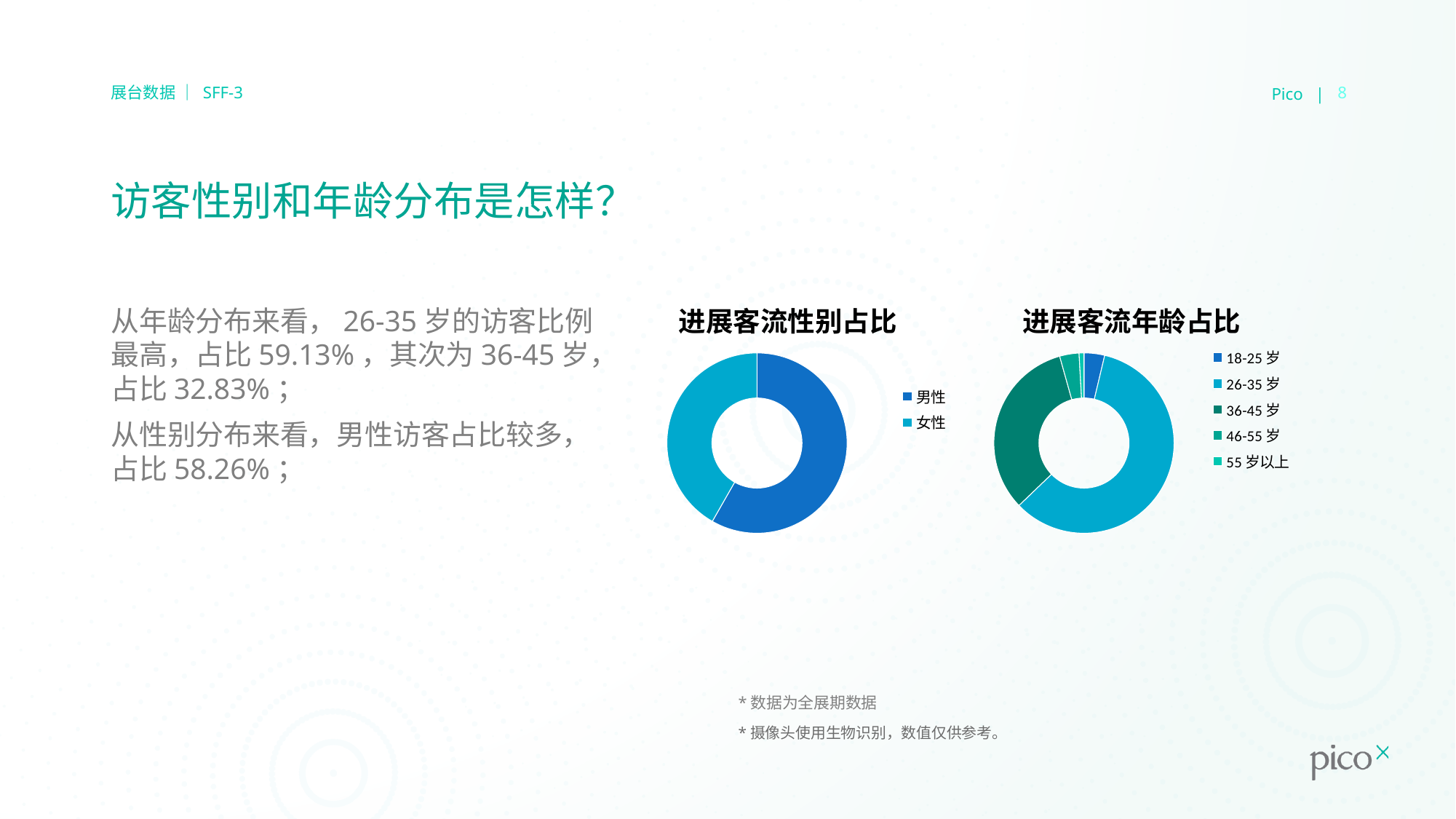
In the 进展客流年龄占比 chart, what is the share of the 26-35 岁 group? 59.13% In the 进展客流年龄占比 chart, which age group has the largest share? 26-35 岁 What kind of chart is the 进展客流性别占比 chart? Donut (pie) chart What is the title of the chart on the right side of the slide? 进展客流年龄占比 How many categories does the legend of the 进展客流性别占比 chart list? 2 In the 进展客流年龄占比 chart, what is the share of the 36-45 岁 group? 32.83% In the 进展客流年龄占比 chart, what is the difference between the shares of the 26-35 岁 and 36-45 岁 groups? 26.30% In the 进展客流年龄占比 chart, which age group is the second largest? 36-45 岁 How many categories does the legend of the 进展客流年龄占比 chart list? 5 In the 进展客流性别占比 chart, what is the share of 男性? 58.26% In the 进展客流年龄占比 chart, which is larger: the 36-45 岁 slice or the 46-55 岁 slice? 36-45 岁 In the 进展客流性别占比 chart, which category has the larger share? 男性